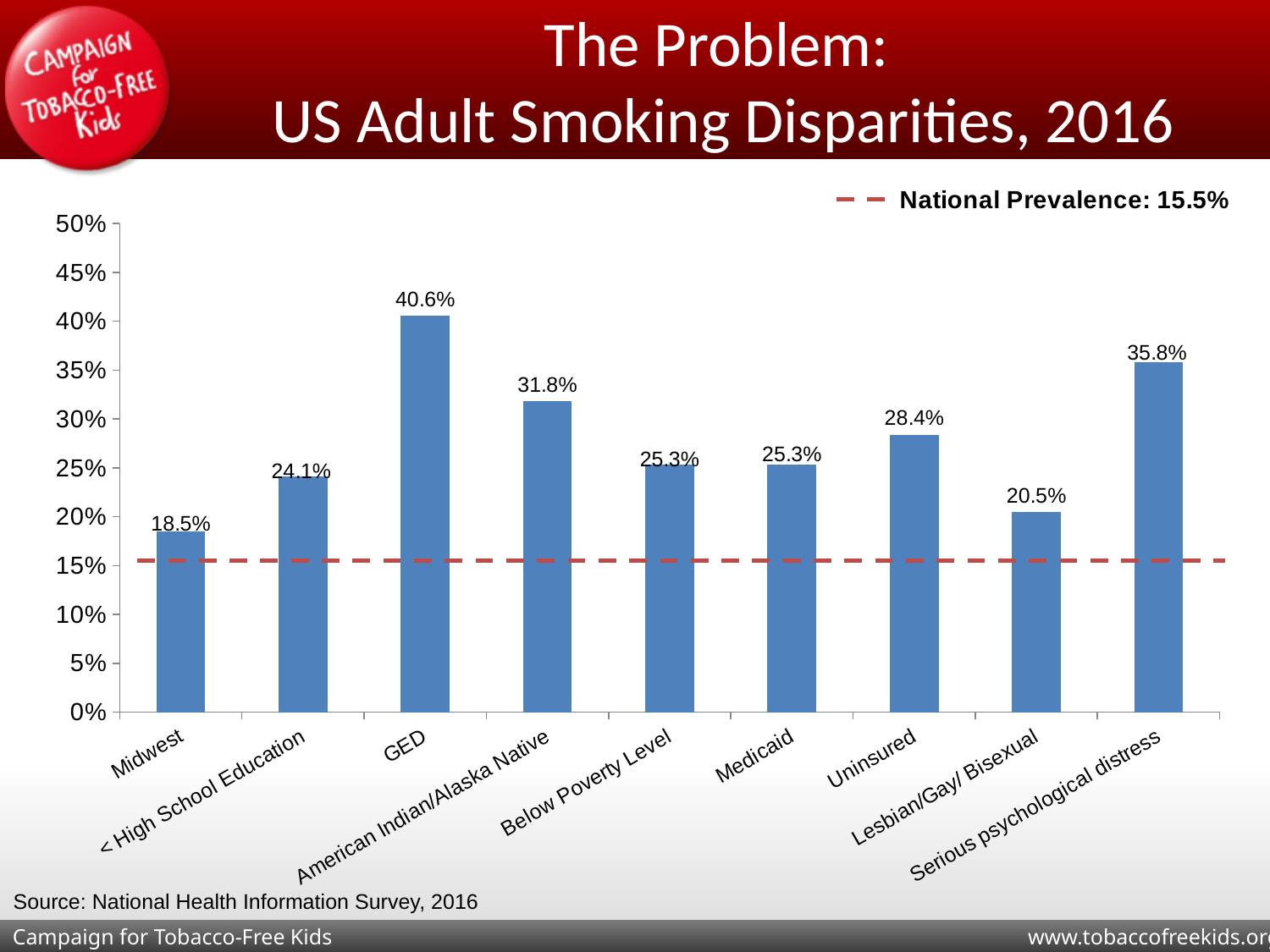
Which has a higher smoking prevalence, American Indian/Alaska Native or Uninsured? American Indian/Alaska Native What is the source cited for the chart data? National Health Information Survey, 2016 What is the difference between the smoking prevalence for Midwest and the National Prevalence of 15.5%? 3.0% What is the National Prevalence value shown in the legend? 15.5% Which category has the highest smoking prevalence? GED How many categories are shown on the x axis? 9 What is the smoking prevalence for GED? 40.6% Which category has the lowest smoking prevalence? Midwest What is the smoking prevalence for Lesbian/Gay/ Bisexual? 20.5% What is the smoking prevalence for Uninsured? 28.4% What is the difference between the smoking prevalence for GED and for Serious psychological distress? 4.8% What kind of chart is shown on the slide? Bar chart